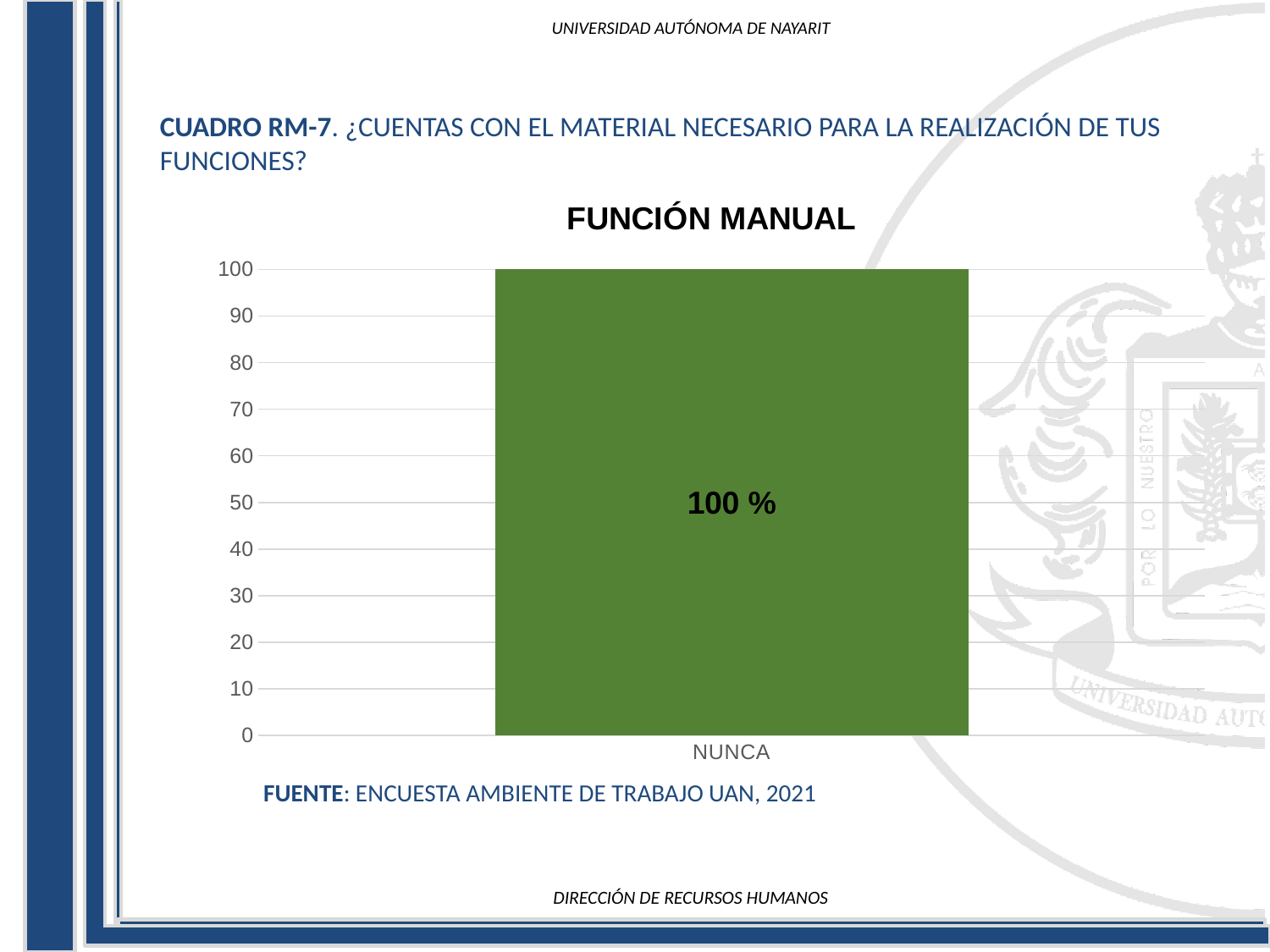
What is the title of the chart? FUNCIÓN MANUAL What kind of chart is shown on the slide? bar chart What is the highest value shown on the vertical axis? 100 What is the value for NUNCA? 100 % Which category is shown on the x axis? NUNCA Is the value for NUNCA greater or less than 50? greater How many categories are plotted on the x axis? 1